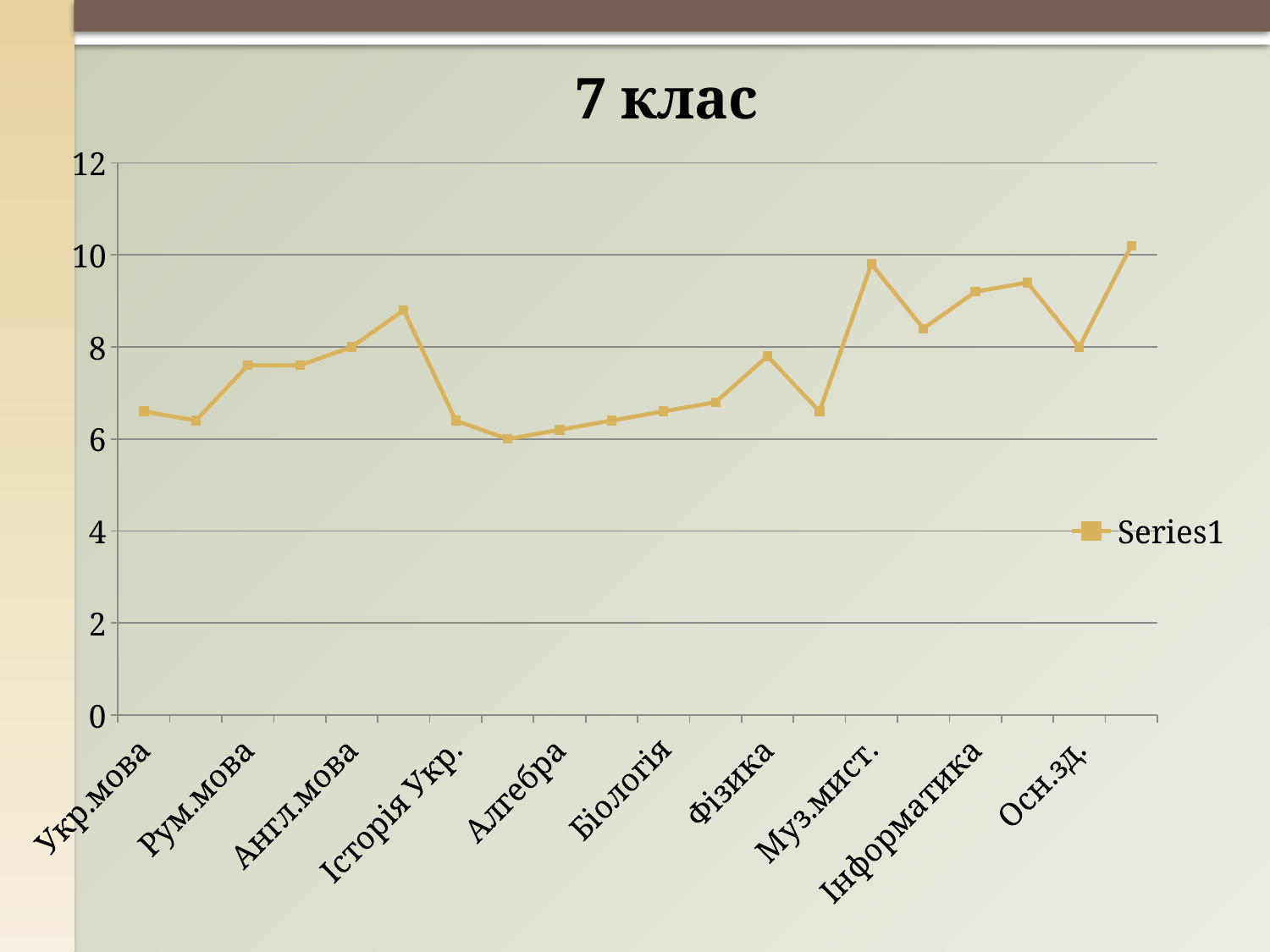
Is the value for Муз.мист. greater or less than 8? greater How many series does the legend list? 1 Which is larger, the value for Інформатика or the value for Історія Укр.? Інформатика Is the value for Укр.мова greater or less than 8? less What kind of chart is shown on the slide? line chart What is the name of the series shown in the legend? Series1 Is the value for Алгебра greater or less than 8? less What is the title of the chart? 7 клас Which is larger, the value for Муз.мист. or the value for Алгебра? Муз.мист. Do the values rise or fall from Алгебра to Фізика? rise How many category labels are shown on the x axis? 10